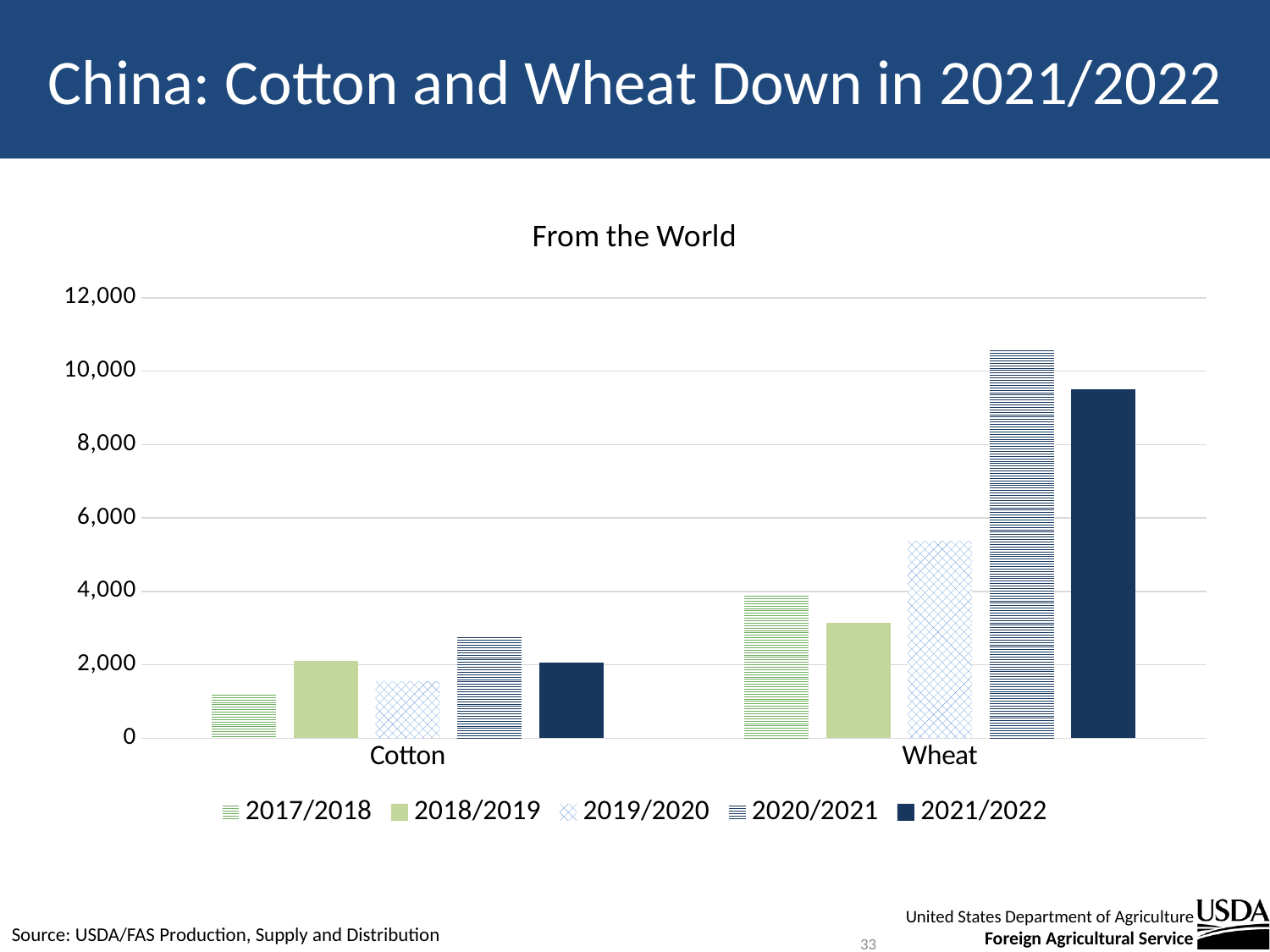
For Cotton, which year has the lowest value? 2017/2018 How many series does the legend list? 5 Is the Wheat value for 2021/2022 greater or less than 10,000? less Is the Wheat value for 2020/2021 greater or less than 10,000? greater For Cotton, which year has the highest value? 2020/2021 What is the title of the chart? From the World For Wheat, which year has the highest value? 2020/2021 Is the Cotton value for 2017/2018 greater or less than 2,000? less What kind of chart is shown on the slide? bar chart How many commodity categories are shown on the x axis? 2 For Wheat, which is larger: the 2019/2020 value or the 2017/2018 value? 2019/2020 For Wheat, which year has the lowest value? 2018/2019